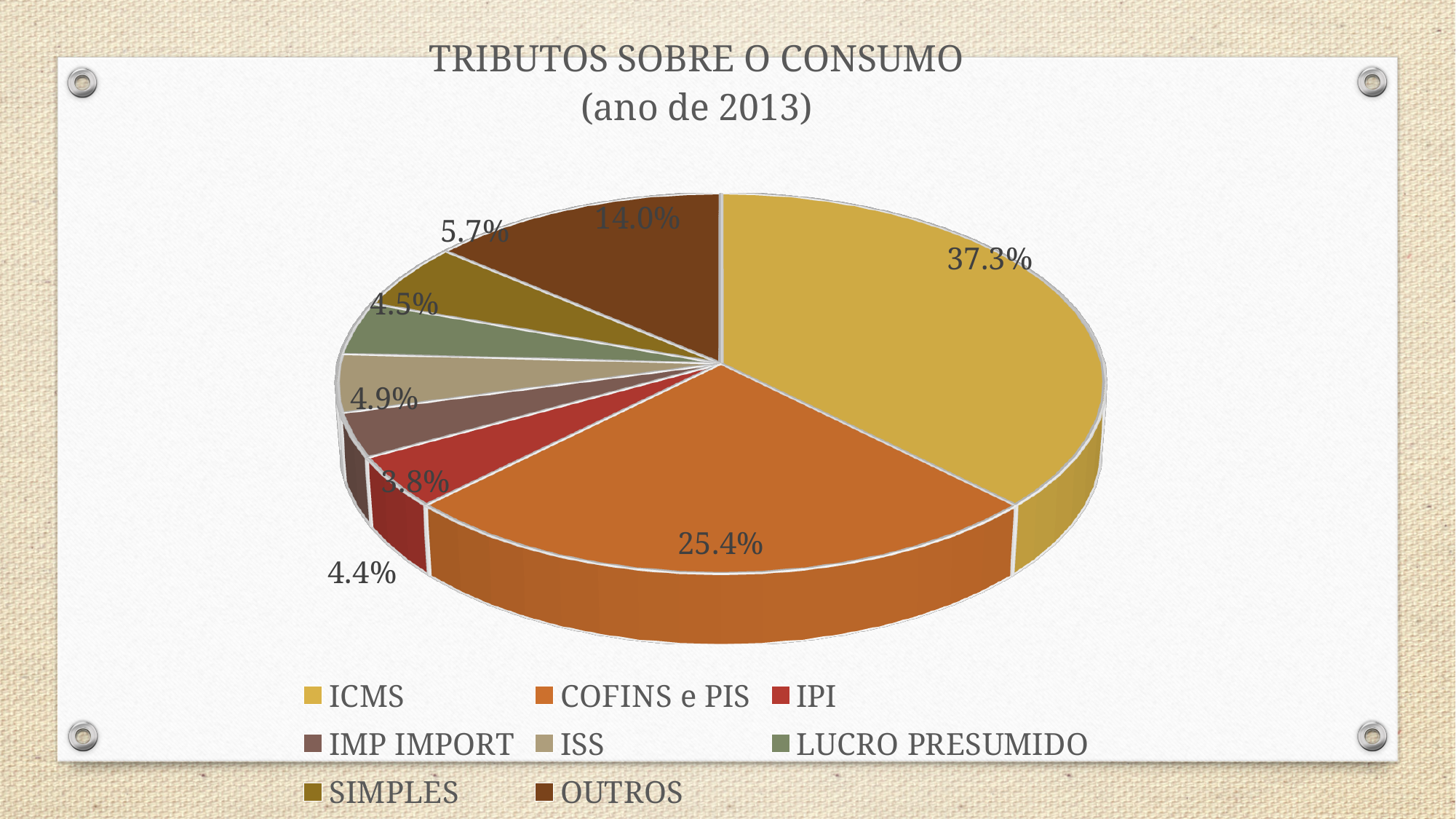
What is the difference between the ICMS and COFINS e PIS shares? 11.9% Which category has the largest slice of the pie? ICMS What kind of chart is shown on the slide? pie chart What is the value shown for COFINS e PIS? 25.4% What is the value shown for SIMPLES? 5.7% Which is larger, the share for ISS or the share for LUCRO PRESUMIDO? ISS What is the title of the chart? TRIBUTOS SOBRE O CONSUMO (ano de 2013) What share of the pie does ICMS represent? 37.3% Which category is shown in red in the legend? IPI What is the value shown for OUTROS? 14.0% How many categories does the pie chart have? 8 Which category has the smallest slice of the pie? IMP IMPORT